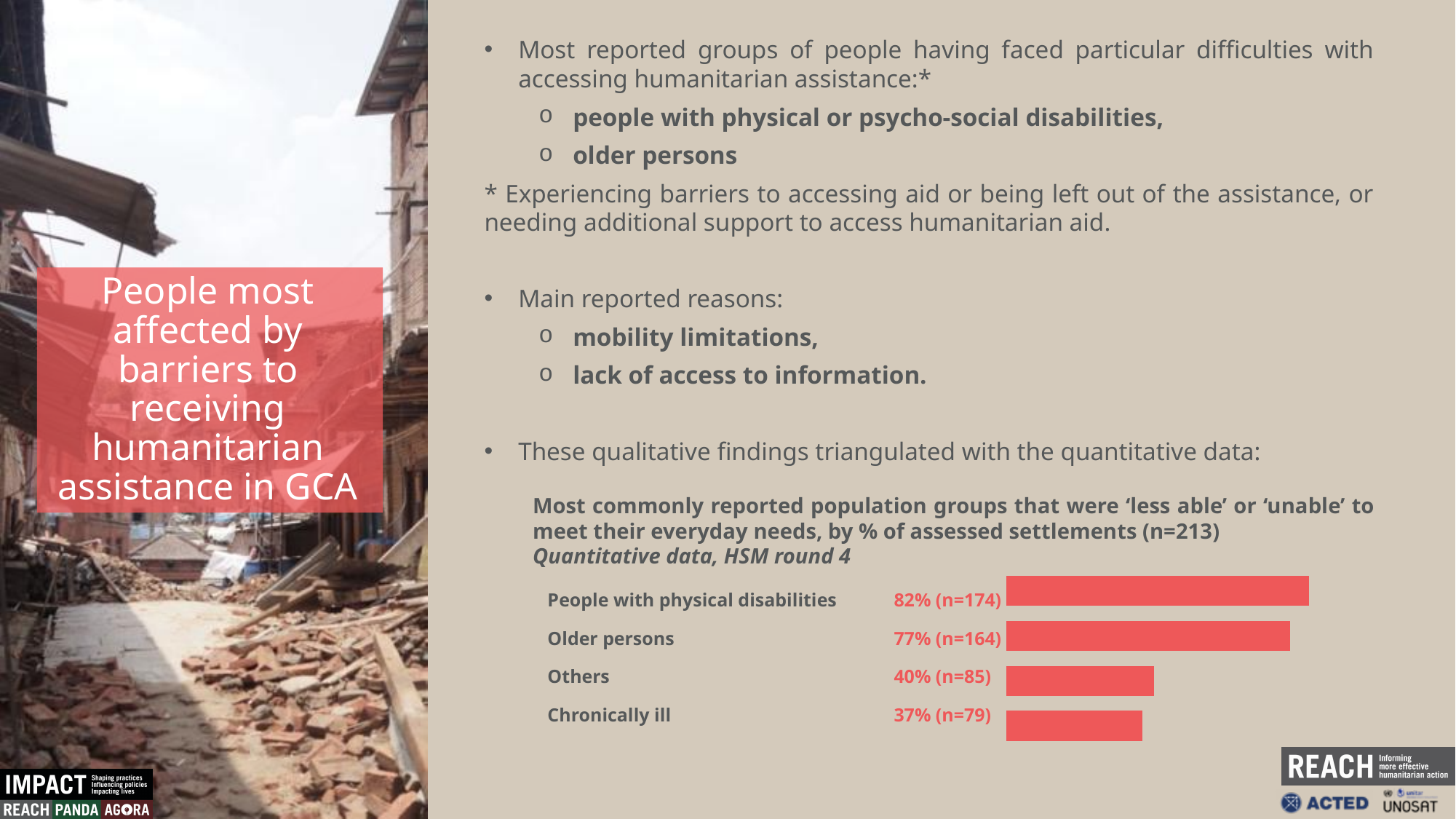
What percentage of assessed settlements reported people with physical disabilities as less able or unable to meet their everyday needs? 82% Which population group has the highest percentage of assessed settlements? People with physical disabilities What type of chart is used to show the population groups? Bar chart How many settlements (n) reported 'Others' as a group less able or unable to meet their everyday needs? 85 What is the total number of assessed settlements (n) stated in the chart title? 213 What is the difference in percentage points between 'Others' and 'Chronically ill'? 3 percentage points Which population group has the lowest percentage of assessed settlements? Chronically ill What percentage of assessed settlements reported older persons as less able or unable to meet their everyday needs? 77% What is the difference in percentage points between 'People with physical disabilities' and 'Older persons'? 5 percentage points What percentage is shown for the 'Chronically ill' category? 37% Which has a higher percentage: 'Older persons' or 'Others'? Older persons How many population groups are shown in the chart? 4